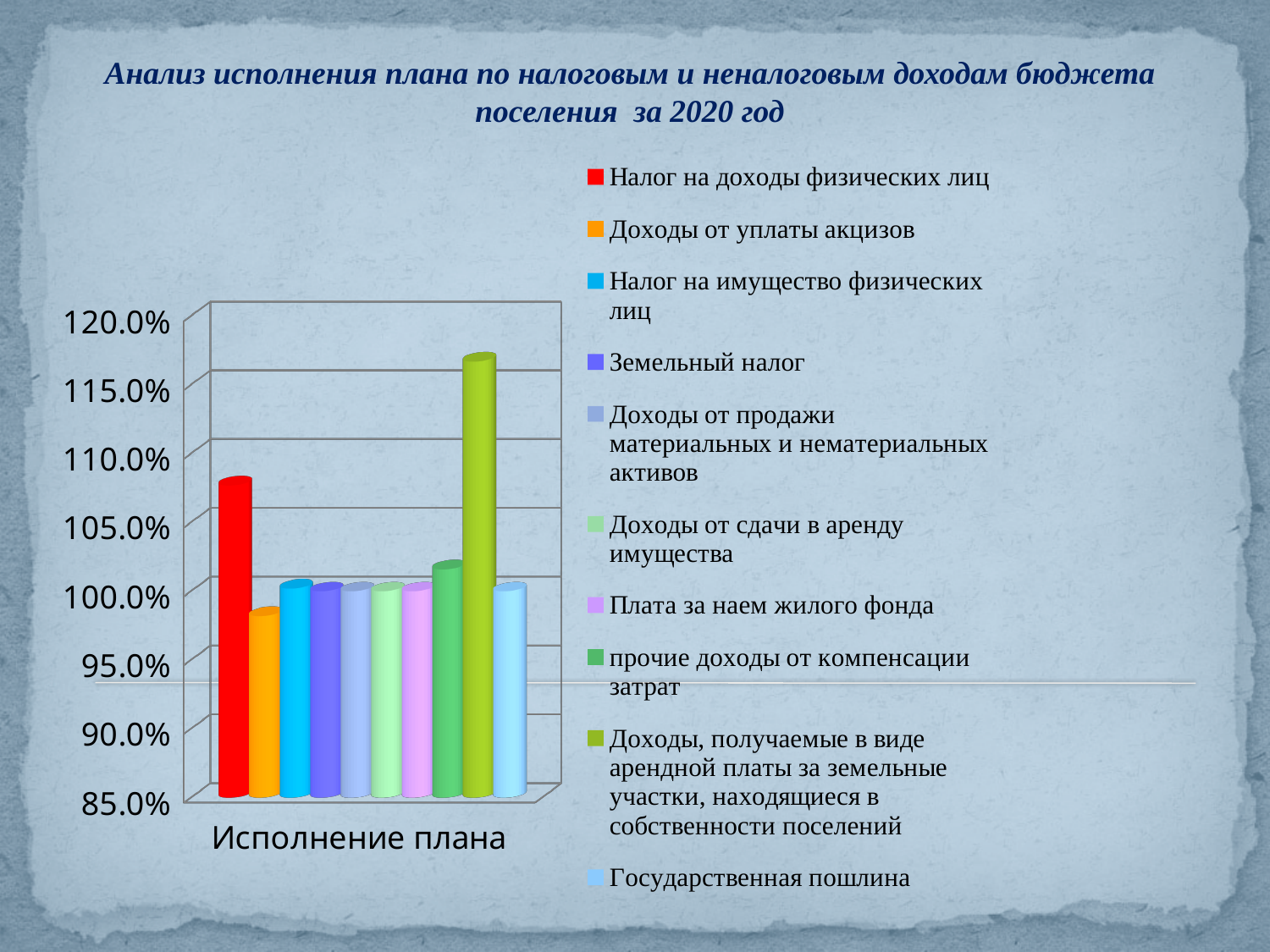
How many categories are shown on the x axis? 1 What is the category label on the x axis? Исполнение плана Is the value for Доходы от уплаты акцизов greater or less than 100.0%? less Is the value for Налог на доходы физических лиц greater or less than 105.0%? greater How many series does the legend list? 10 What colour is the bar for Налог на доходы физических лиц? red Which is larger: the value for Налог на доходы физических лиц or the value for Доходы от уплаты акцизов? Налог на доходы физических лиц Which series has the lowest value? Доходы от уплаты акцизов Is the value for Доходы, получаемые в виде арендной платы за земельные участки, находящиеся в собственности поселений greater or less than 115.0%? greater What kind of chart is shown on the slide? bar chart Which is larger: the value for Налог на доходы физических лиц or the value for Доходы, получаемые в виде арендной платы за земельные участки, находящиеся в собственности поселений? Доходы, получаемые в виде арендной платы за земельные участки, находящиеся в собственности поселений Which series has the highest value? Доходы, получаемые в виде арендной платы за земельные участки, находящиеся в собственности поселений